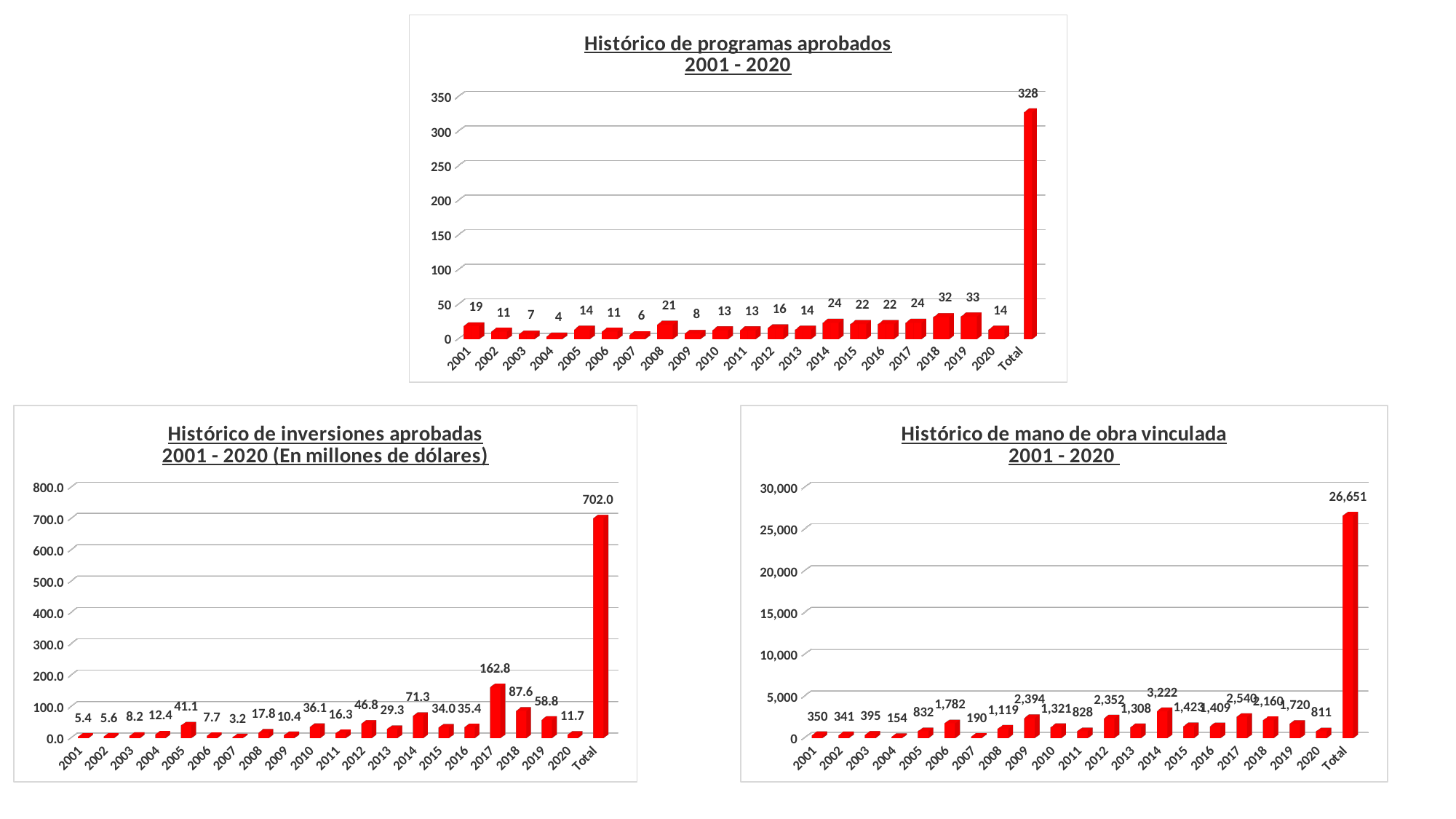
In the chart 'Histórico de inversiones aprobadas 2001 - 2020', what is the value for 2017? 162.8 In the chart 'Histórico de inversiones aprobadas 2001 - 2020', which is larger, the value for 2014 or the value for 2018? 2018 How many bars are plotted in the chart 'Histórico de mano de obra vinculada 2001 - 2020', including the Total bar? 21 In the chart 'Histórico de programas aprobados 2001 - 2020', which year between 2001 and 2020 has the lowest value? 2004 In the chart 'Histórico de mano de obra vinculada 2001 - 2020', what is the value for 2014? 3,222 In the chart 'Histórico de programas aprobados 2001 - 2020', what is the difference between the values for 2018 and 2020? 18 In the chart 'Histórico de inversiones aprobadas 2001 - 2020', which year between 2001 and 2020 has the lowest value? 2007 In the chart 'Histórico de programas aprobados 2001 - 2020', what is the value for 2019? 33 In the chart 'Histórico de inversiones aprobadas 2001 - 2020', what is the value of the Total bar? 702.0 In the chart 'Histórico de mano de obra vinculada 2001 - 2020', which year between 2001 and 2020 has the highest value? 2014 In the chart 'Histórico de mano de obra vinculada 2001 - 2020', what is the difference between the values for 2009 and 2010? 1,073 In the chart 'Histórico de programas aprobados 2001 - 2020', what is the value of the Total bar? 328